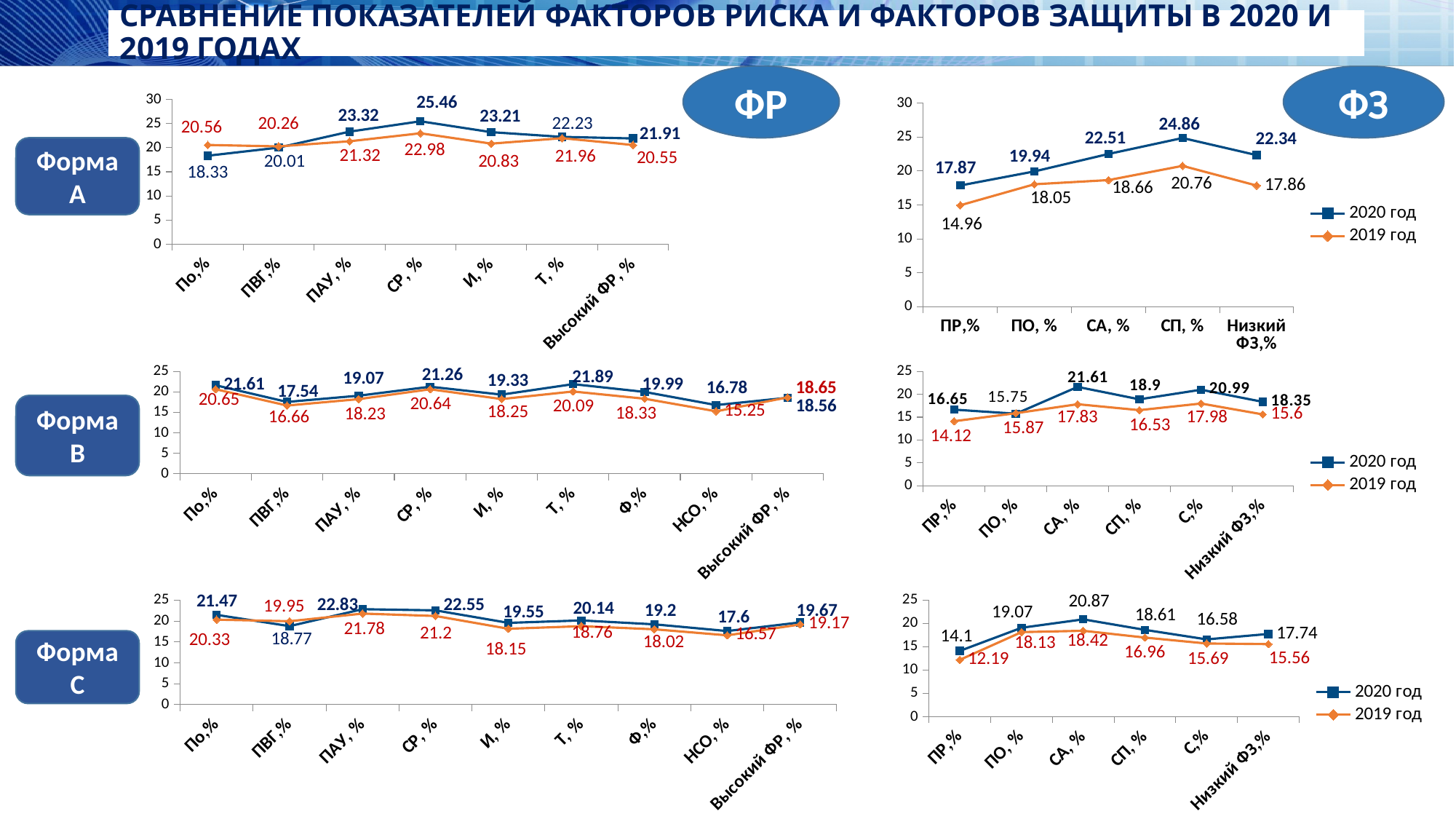
In the Форма B ФР chart (middle left), which category has the lowest 2019 год value? НСО, % In the Форма C ФЗ chart (bottom right), which category has the highest 2019 год value? СА, % In the Форма A ФЗ chart (top right), does the 2019 год series rise or fall from ПР,% to СП, %? Rise What kind of chart is the Форма C ФР chart (bottom left)? Line chart In the Форма C ФЗ chart (bottom right), what is the 2020 год value for Низкий ФЗ,%? 17.74 How many series does the legend of the Форма A ФЗ chart (top right) list? 2 In the Форма A ФЗ chart (top right), which category has the highest 2020 год value? СП, % How many categories are shown on the x axis of the Форма B ФР chart (middle left)? 9 In the Форма A ФР chart (top left), what is the 2020 год value for СР, %? 25.46 In the Форма C ФР chart (bottom left), which is larger for ПВГ,%: the 2020 год value or the 2019 год value? 2019 год In the Форма B ФЗ chart (middle right), what is the difference between the 2020 год and 2019 год values for СА, %? 3.78 In the Форма A ФЗ chart (top right), what is the 2019 год value for ПР,%? 14.96